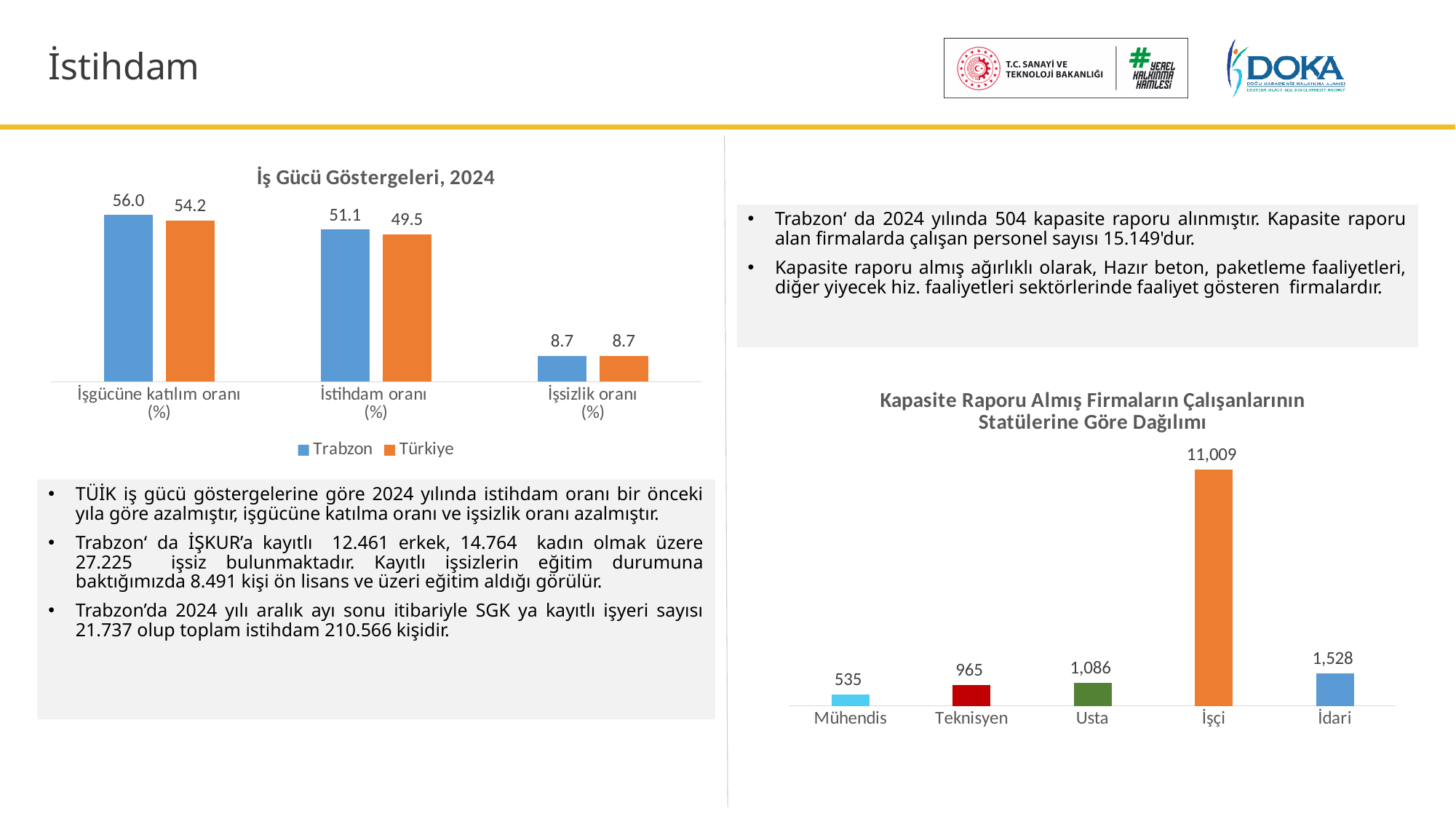
In the 'İş Gücü Göstergeleri, 2024' chart, how many series does the legend list? 2 In the 'İş Gücü Göstergeleri, 2024' chart, what is the value for Türkiye for İstihdam oranı (%)? 49.5 In the 'Kapasite Raporu Almış Firmaların Çalışanlarının Statülerine Göre Dağılımı' chart, which category has the highest value? İşçi In the 'Kapasite Raporu Almış Firmaların Çalışanlarının Statülerine Göre Dağılımı' chart, what is the difference between İdari and Teknisyen? 563 In the 'Kapasite Raporu Almış Firmaların Çalışanlarının Statülerine Göre Dağılımı' chart, what is the value for Usta? 1,086 In the 'İş Gücü Göstergeleri, 2024' chart, what is the value for Trabzon for İşsizlik oranı (%)? 8.7 In the 'İş Gücü Göstergeleri, 2024' chart, what is the value for Trabzon for İşgücüne katılım oranı (%)? 56.0 In the 'İş Gücü Göstergeleri, 2024' chart, what is the difference between Trabzon and Türkiye for İşgücüne katılım oranı (%)? 1.8 In the 'Kapasite Raporu Almış Firmaların Çalışanlarının Statülerine Göre Dağılımı' chart, how many categories are shown? 5 What kind of chart is 'Kapasite Raporu Almış Firmaların Çalışanlarının Statülerine Göre Dağılımı'? Bar chart In the 'Kapasite Raporu Almış Firmaların Çalışanlarının Statülerine Göre Dağılımı' chart, which category has the lowest value? Mühendis In the 'İş Gücü Göstergeleri, 2024' chart, which is larger for İstihdam oranı (%): Trabzon or Türkiye? Trabzon